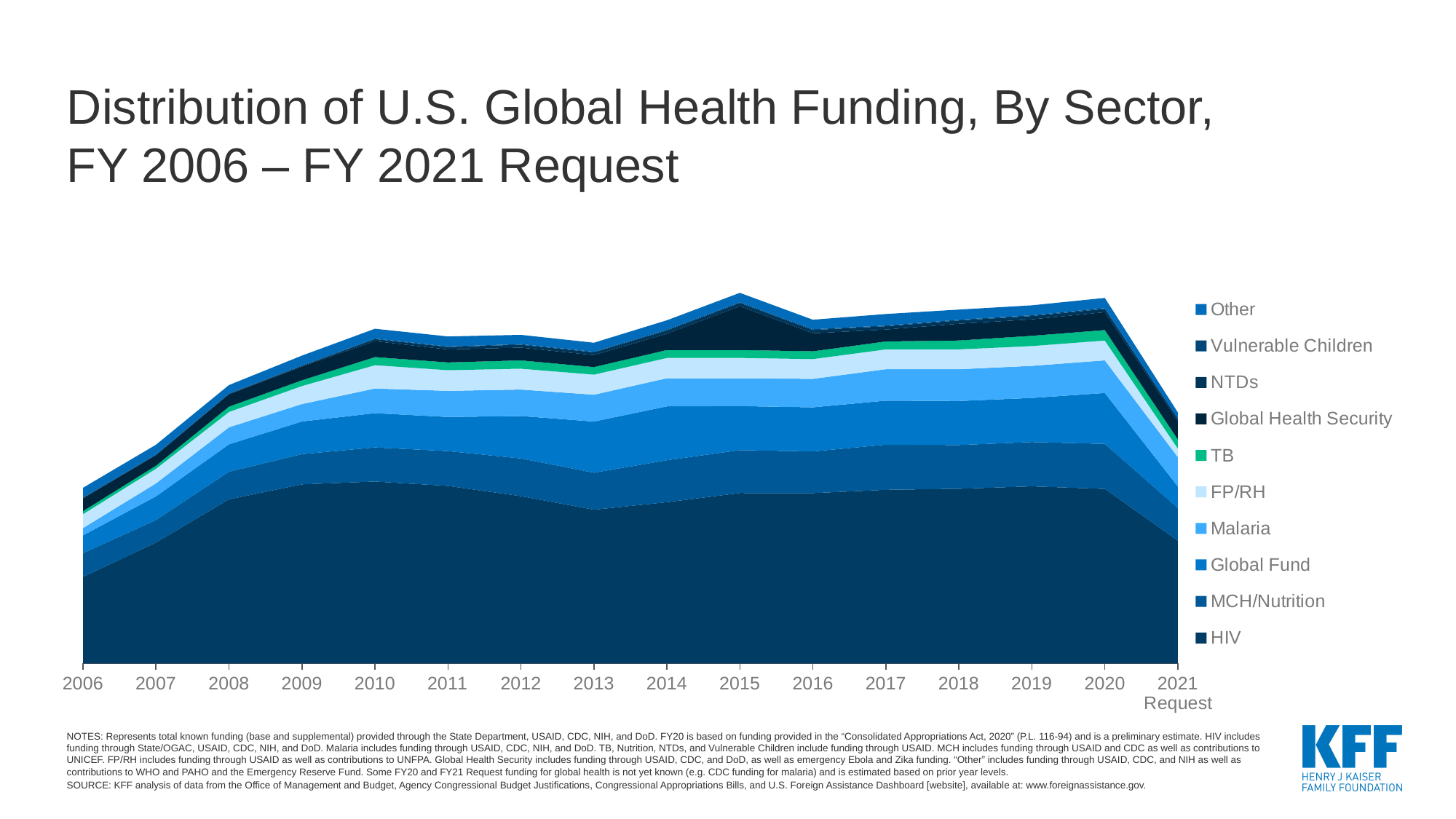
What kind of chart is shown on the slide? Stacked area chart Does total global health funding rise or fall from 2020 to the 2021 Request? Fall Which sector is shown in green in the chart? TB How many series does the legend list? 10 Which sector accounts for the largest share of U.S. global health funding across the years shown? HIV How many fiscal years are shown along the x axis? 16 Does total global health funding rise or fall from 2015 to 2016? Fall Is total funding larger in 2006 or in 2010? 2010 Is total funding larger in 2020 or in the 2021 Request? 2020 In which year is total U.S. global health funding lowest? 2006 What is the title of the chart? Distribution of U.S. Global Health Funding, By Sector, FY 2006 – FY 2021 Request Does total global health funding rise or fall from 2006 to 2008? Rise